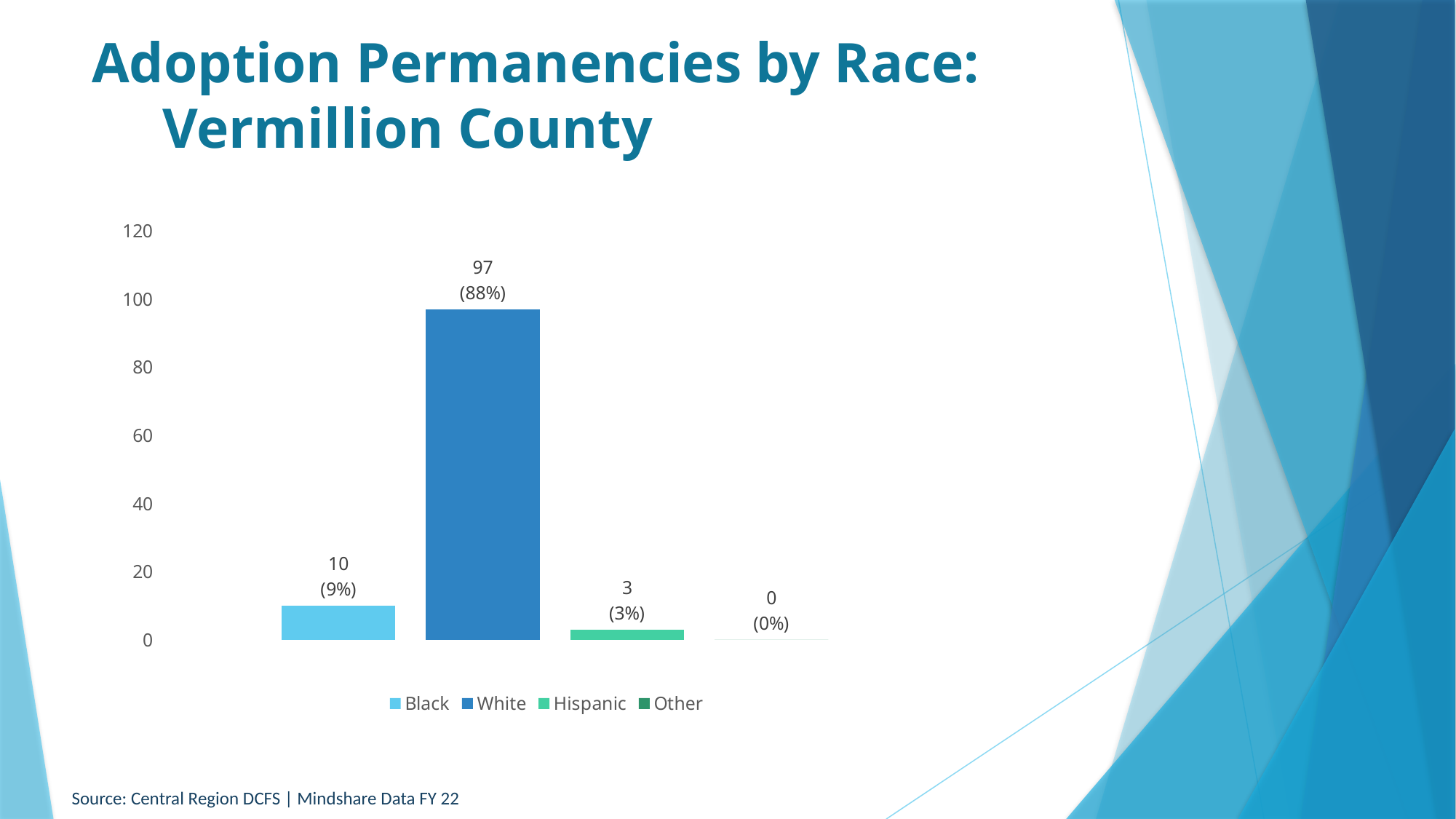
Which race category has the lowest number of adoption permanencies? Other Is the value for White greater or less than 80? greater Which race category has the highest number of adoption permanencies? White What is the number of adoption permanencies for White? 97 What is the number of adoption permanencies for Hispanic? 3 How many race categories are shown in the chart? 4 What kind of chart is shown on the slide? Bar chart Which is larger, the value for Black or the value for Hispanic? Black What percentage share is shown for the Other category? 0% What is the source cited at the bottom of the slide? Central Region DCFS | Mindshare Data FY 22 What is the number of adoption permanencies for Black? 10 What is the difference between the White and Black values? 87